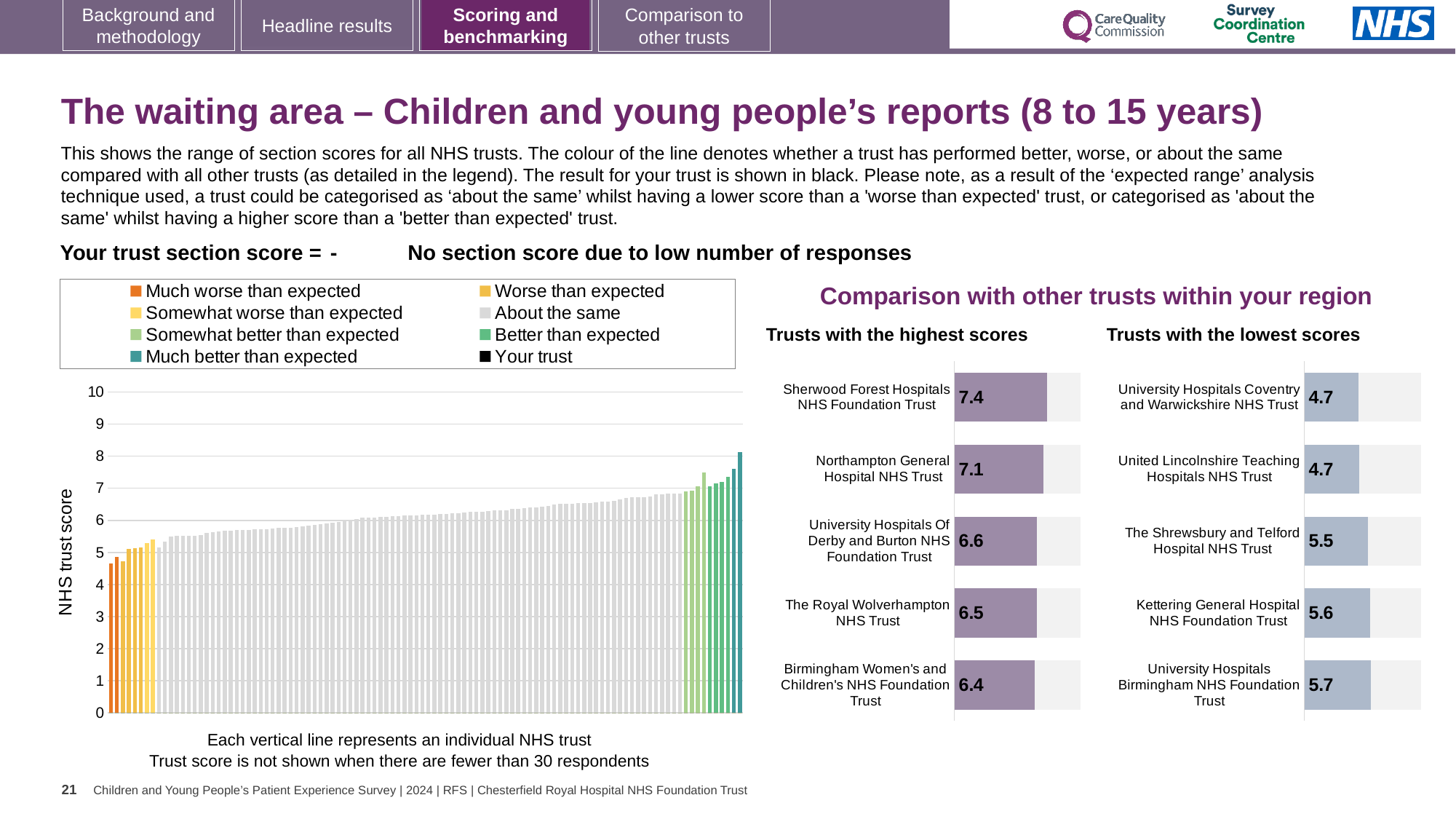
How many entries does the legend above the large 'NHS trust score' chart list? 8 In the 'Trusts with the lowest scores' chart, which trust has the highest score shown? University Hospitals Birmingham NHS Foundation Trust How many trusts are listed in the 'Trusts with the lowest scores' chart? 5 In the 'Trusts with the lowest scores' chart, what is the difference between the scores of University Hospitals Birmingham NHS Foundation Trust and United Lincolnshire Teaching Hospitals NHS Trust? 1.0 In the large 'NHS trust score' chart, is the value of the lowest (leftmost) bar greater or less than 5? less In the 'Trusts with the highest scores' chart, what is the difference between the scores of Sherwood Forest Hospitals NHS Foundation Trust and Birmingham Women's and Children's NHS Foundation Trust? 1.0 In the 'Trusts with the highest scores' chart, what is the score for University Hospitals Of Derby and Burton NHS Foundation Trust? 6.6 In the large 'NHS trust score' chart, do the bar values rise or fall from left to right? rise In the 'Trusts with the lowest scores' chart, what is the score for The Shrewsbury and Telford Hospital NHS Trust? 5.5 In the 'Trusts with the highest scores' chart, which trust has the lowest score shown? Birmingham Women's and Children's NHS Foundation Trust In the 'Trusts with the highest scores' chart, which has the higher score: Northampton General Hospital NHS Trust or The Royal Wolverhampton NHS Trust? Northampton General Hospital NHS Trust In the 'Trusts with the highest scores' chart, what is the score for Sherwood Forest Hospitals NHS Foundation Trust? 7.4